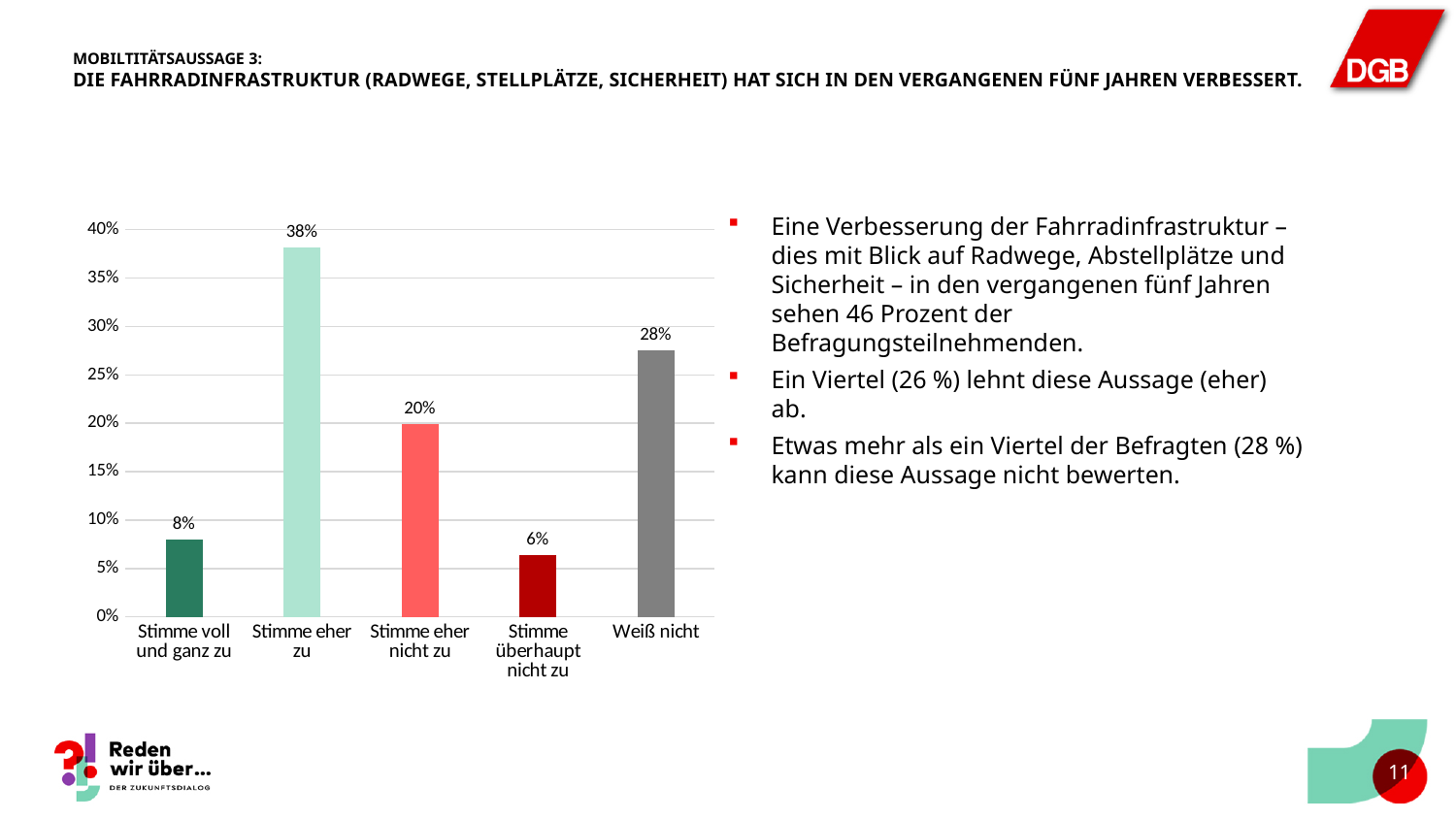
Which category has the highest value? Stimme eher zu Which category has the lowest value? Stimme überhaupt nicht zu Is the value for "Stimme eher nicht zu" greater or less than 15%? greater What is the difference between the values for "Stimme eher zu" and "Stimme eher nicht zu"? 18% What is the value for "Stimme voll und ganz zu"? 8% What is the value for "Stimme überhaupt nicht zu"? 6% What is the value for "Stimme eher zu"? 38% What kind of chart is shown on the slide? Bar chart What is the combined value of "Stimme voll und ganz zu" and "Stimme eher zu"? 46% What is the value for "Weiß nicht"? 28% Which is larger, the value for "Weiß nicht" or the value for "Stimme eher nicht zu"? Weiß nicht How many categories are shown on the x axis? 5